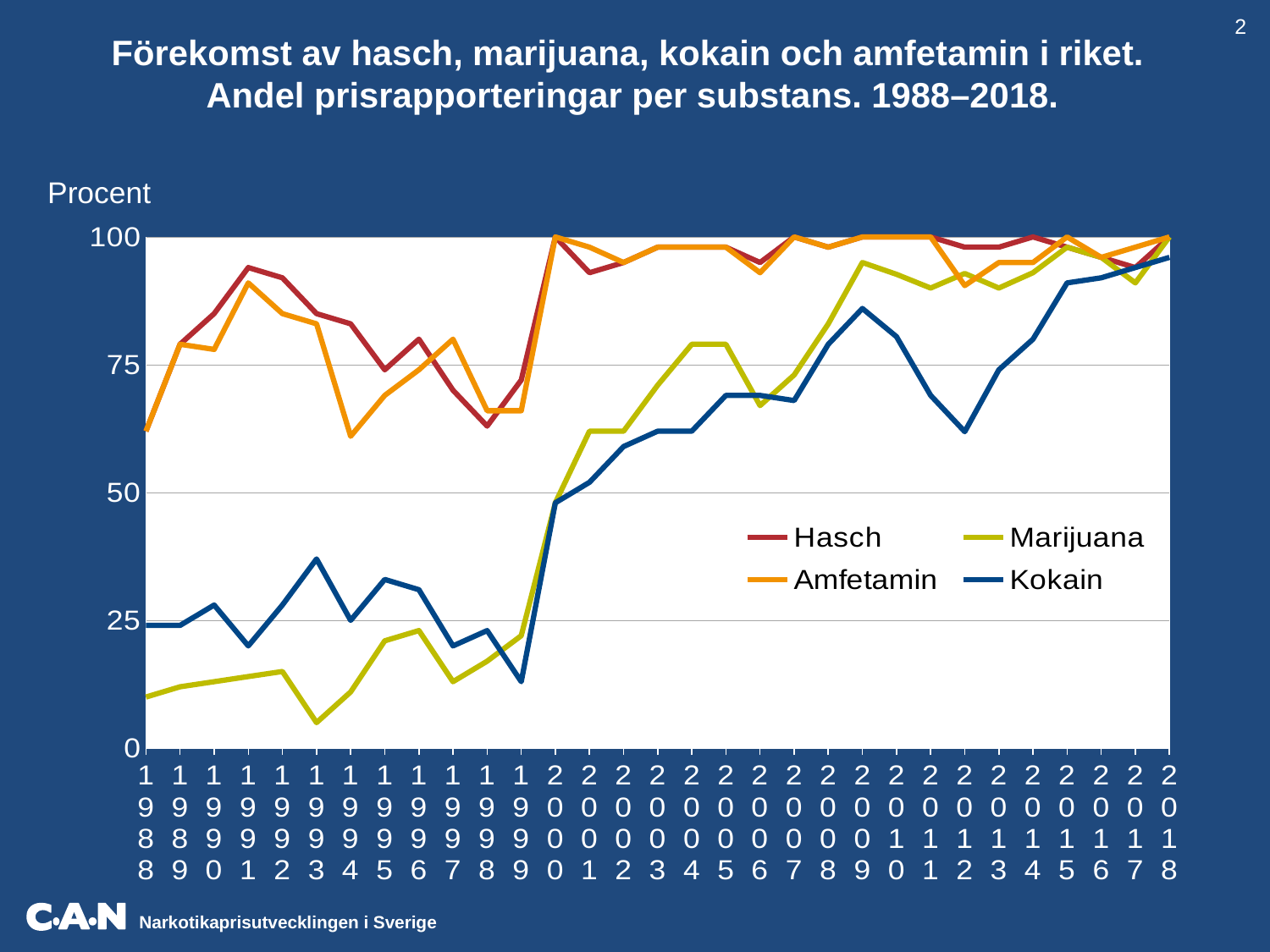
Is the value for Amfetamin in 1994 greater or less than 75? less Is the value for Kokain in 1988 greater or less than 50? less Which series has the lowest value in 1993? Marijuana How many years are plotted along the x axis? 31 Does the Kokain line overall rise or fall from 1988 to 2018? rise In 2012, which is larger, the value for Marijuana or the value for Kokain? Marijuana Is the value for Hasch in 1991 greater or less than 75? greater In 1988, which is larger, the value for Hasch or the value for Marijuana? Hasch How many series does the legend list? 4 What kind of chart is shown on the slide? line chart